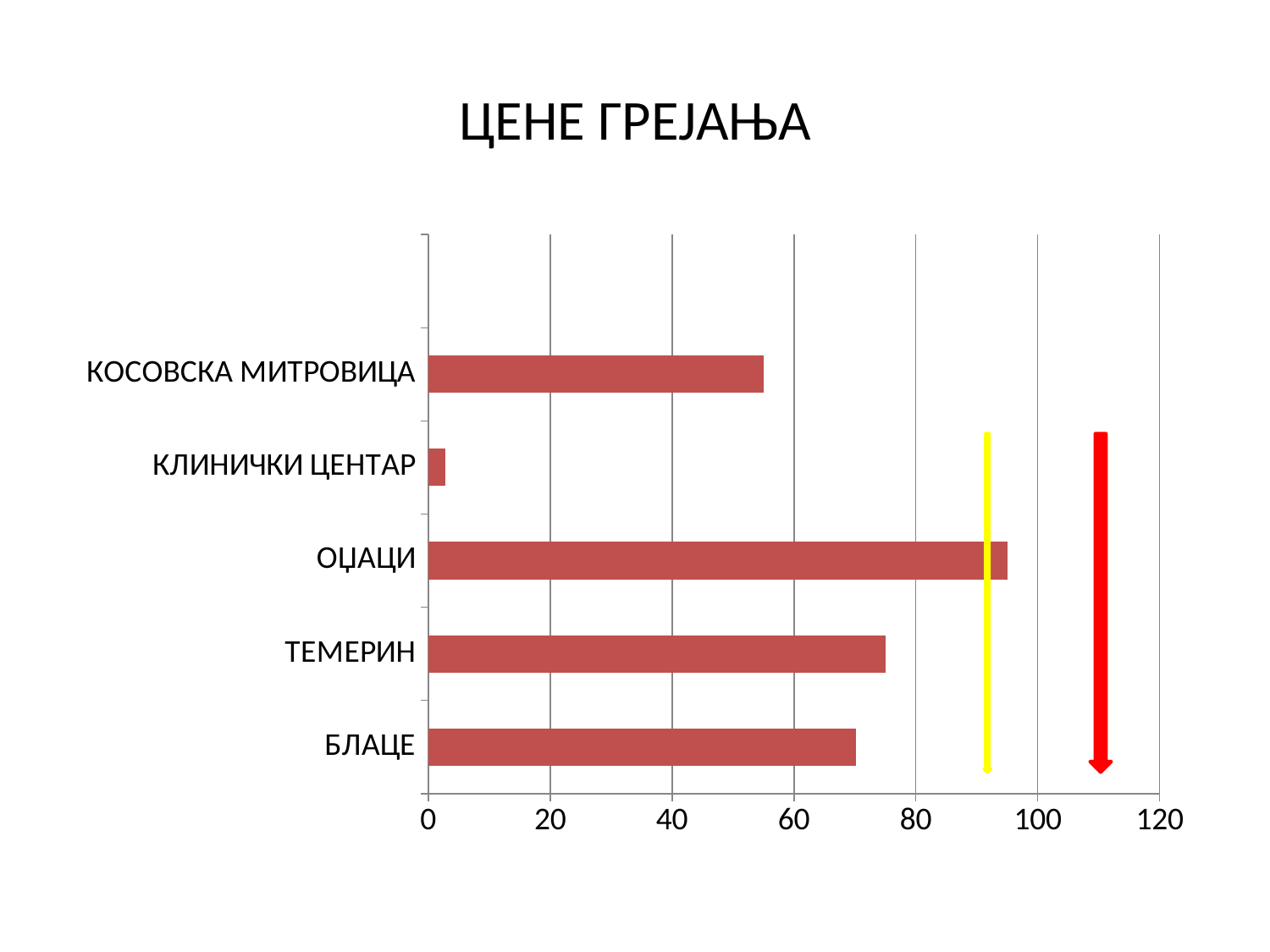
Which category has the lowest value? КЛИНИЧКИ ЦЕНТАР Is the value for ТЕМЕРИН greater or less than 60? greater What is the maximum value shown on the horizontal axis? 120 Which has the larger value, ТЕМЕРИН or КОСОВСКА МИТРОВИЦА? ТЕМЕРИН Is the value for ОЏАЦИ greater or less than 80? greater Which category has the highest value? ОЏАЦИ Is the value for КОСОВСКА МИТРОВИЦА greater or less than 60? less How many categories are plotted in the chart? 5 What kind of chart is shown on the slide? bar chart What is the title of the chart? ЦЕНЕ ГРЕЈАЊА